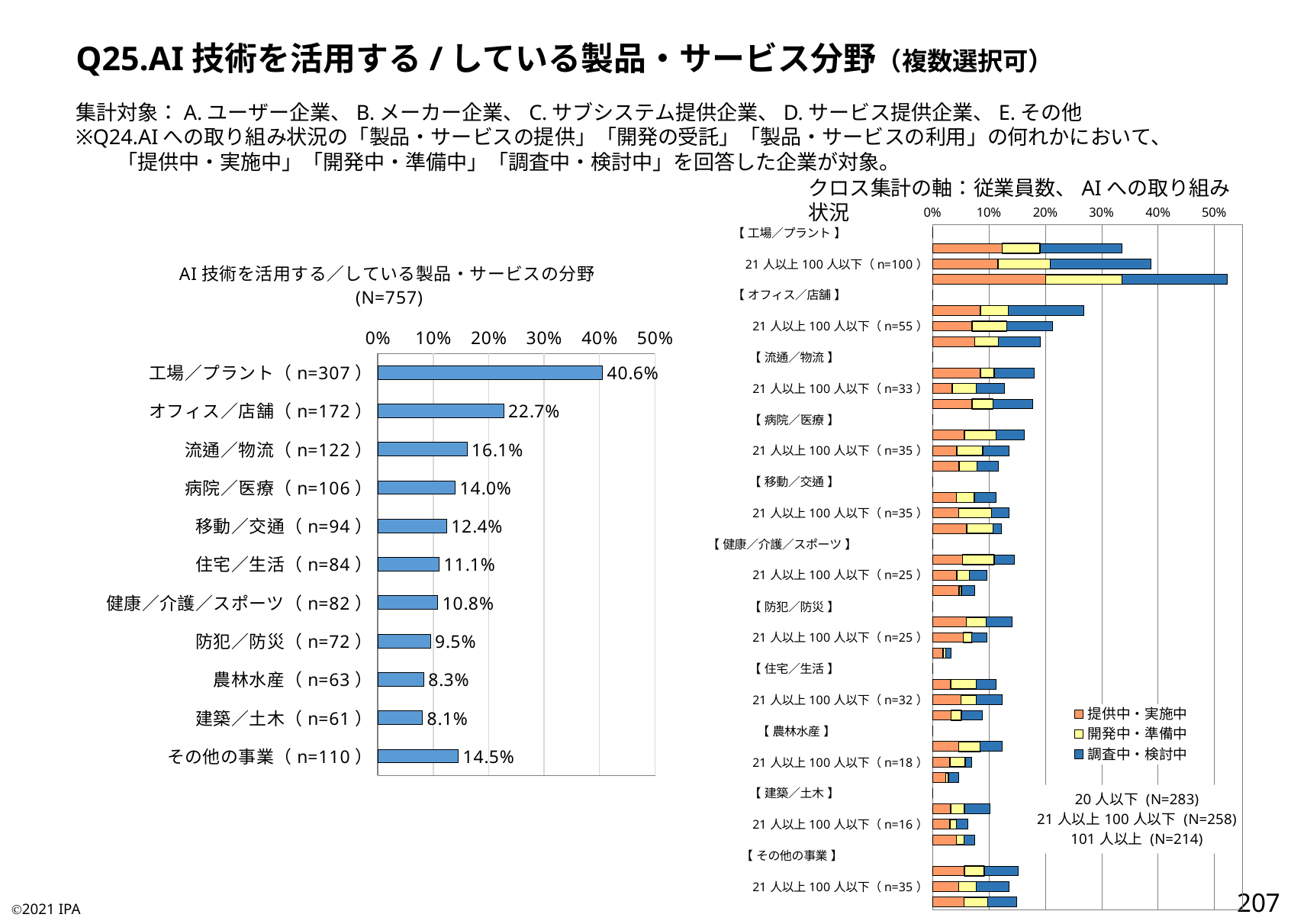
What kind of chart is the left chart? Bar chart In the left chart (AI技術を活用する／している製品・サービスの分野), what is the value for 工場／プラント? 40.6% In the left chart, what is the N shown in the title? N=757 In the right chart, is the total for the 21人以上100人以下 (n=100) bar under 工場／プラント greater or less than 30%? greater In the left chart, which is larger, 流通／物流 or 病院／医療? 流通／物流 In the left chart, how many categories are shown? 11 In the left chart, which category has the highest value? 工場／プラント In the left chart, what is the value for オフィス／店舗? 22.7% In the left chart, which category has the lowest value? 建築／土木 In the right chart, how many series does the legend list? 3 In the left chart, what is the difference between 工場／プラント and オフィス／店舗? 17.9% In the left chart, what is the value for その他の事業? 14.5%